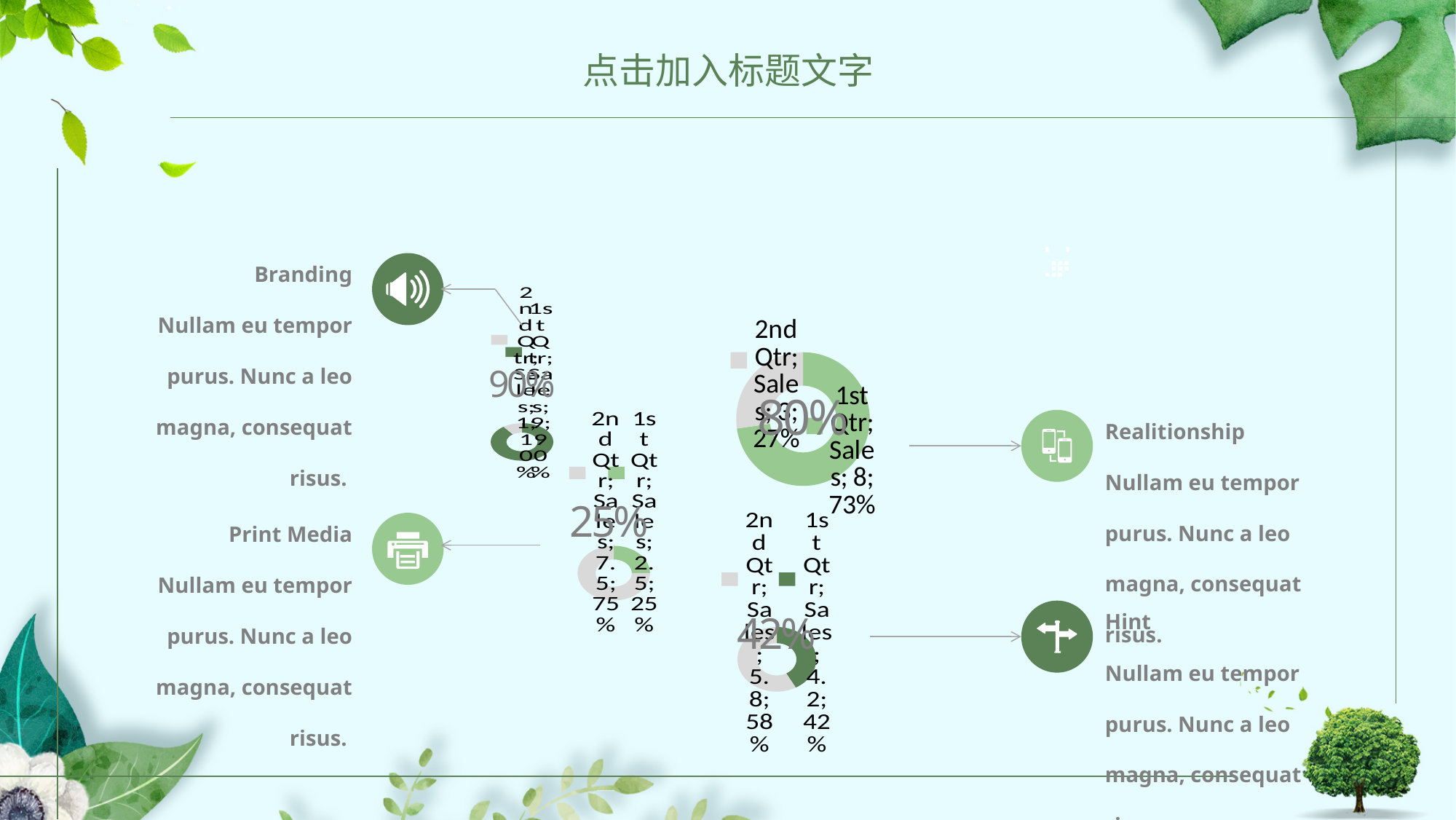
In the doughnut chart labelled 80% (upper right), what share of the pie does 1st Qtr take? 73% In the doughnut chart labelled 42% (lower right), what is the Sales value for 2nd Qtr? 5.8 In the doughnut chart labelled 80% (upper right), which quarter has the larger Sales value? 1st Qtr How many categories does the doughnut chart labelled 42% (lower right) show? 2 In the doughnut chart labelled 80% (upper right), what is the Sales value for 1st Qtr? 8 In the doughnut chart labelled 25%, what is the Sales value for 1st Qtr? 2.5 In the doughnut chart labelled 42% (lower right), what is the Sales value for 1st Qtr? 4.2 In the doughnut chart labelled 25%, what is the Sales value for 2nd Qtr? 7.5 In the doughnut chart labelled 25%, what share of the pie does 2nd Qtr take? 75% In the doughnut chart labelled 80% (upper right), what is the Sales value for 2nd Qtr? 3 In the doughnut chart labelled 42% (lower right), what is the difference between the 2nd Qtr and 1st Qtr Sales values? 1.6 What kind of chart is the chart in the middle of the slide labelled 25%? doughnut chart